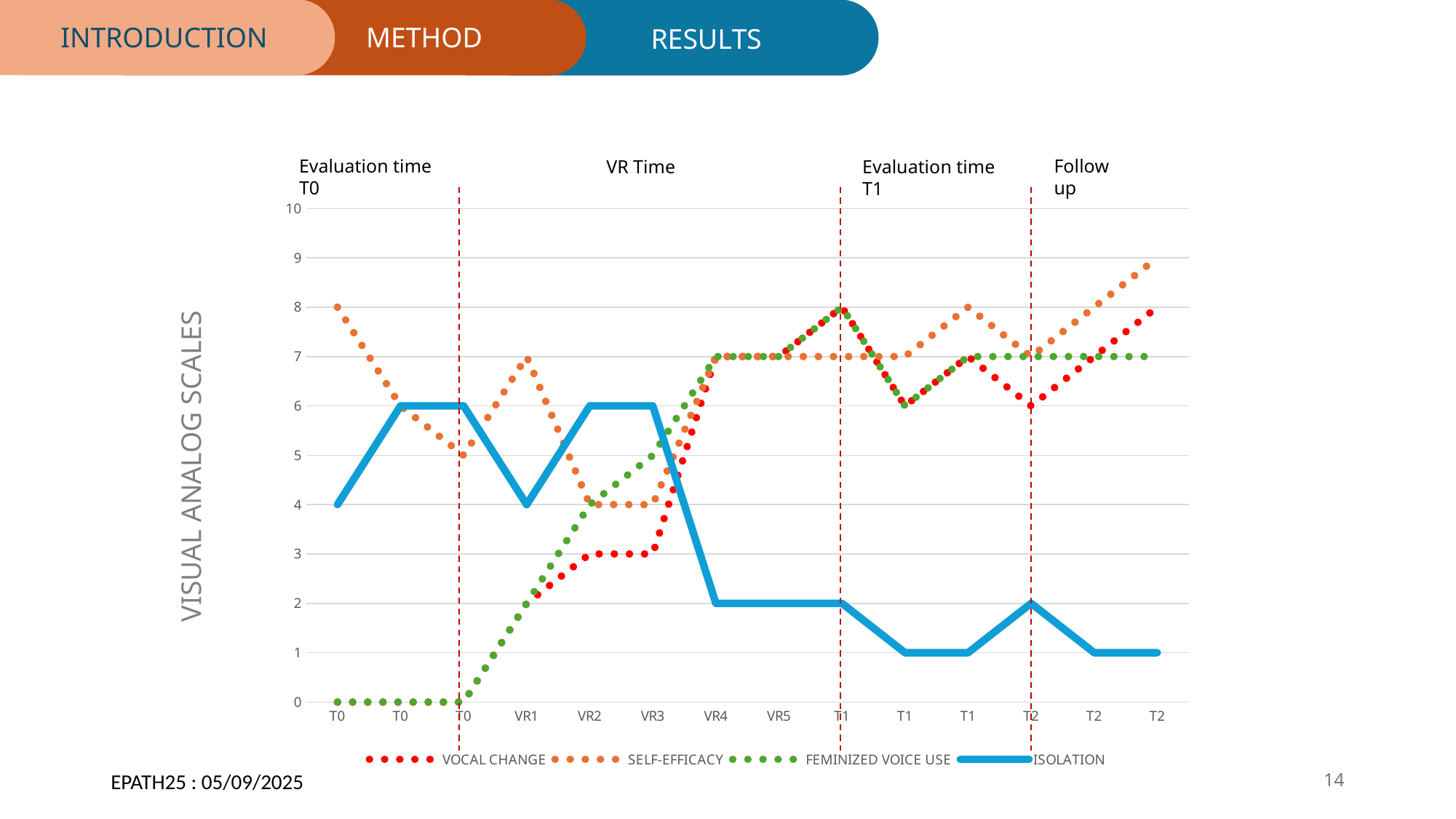
How many points are there along the x axis? 14 What is the FEMINIZED VOICE USE value at the first T0 point? 0 What kind of chart is shown on the slide? line chart Which series is drawn as a solid blue line? ISOLATION What is the ISOLATION value at VR1? 4 At VR2, which is larger: ISOLATION or SELF-EFFICACY? ISOLATION What is the difference between the ISOLATION values at VR3 and VR4? 4 What is the SELF-EFFICACY value at the first T0 point? 8 Which series has the highest value at the first T0 point? SELF-EFFICACY How many series does the legend list? 4 What is the ISOLATION value at the first T0 point? 4 Is the ISOLATION value at VR4 greater or less than 5? less